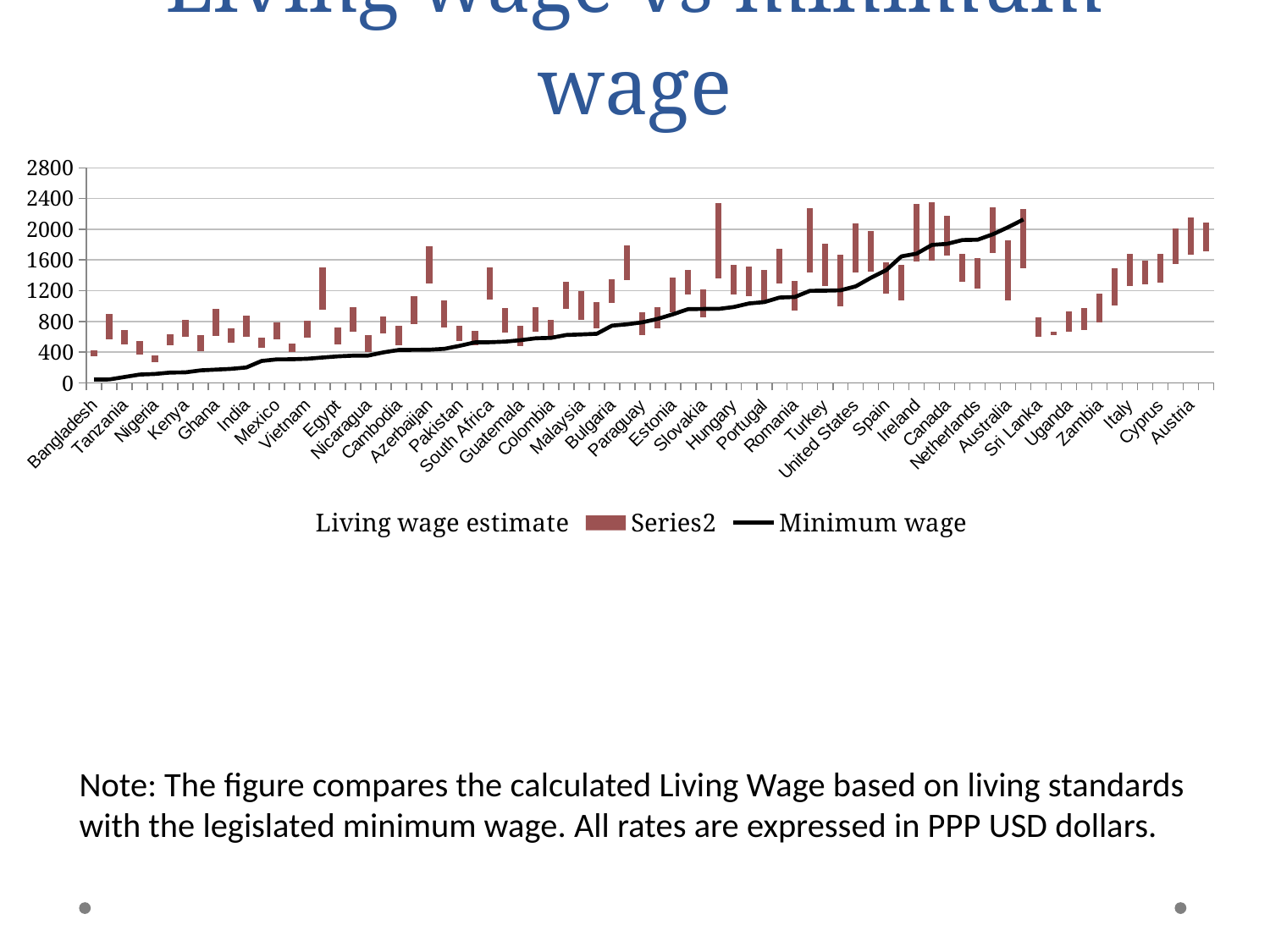
Which series is drawn as a black line? Minimum wage What are the three entries in the legend? Living wage estimate, Series2, Minimum wage Is the Minimum wage value for Hungary greater or less than 800? greater Is the Minimum wage value for Vietnam greater or less than 400? less Is the Minimum wage value for Spain greater or less than 1200? greater Which country has the lowest point on the Minimum wage line? Bangladesh Does the Minimum wage line rise or fall from Bangladesh to Australia? rise How many series does the legend list? 3 What kind of chart is this? Combination bar and line chart